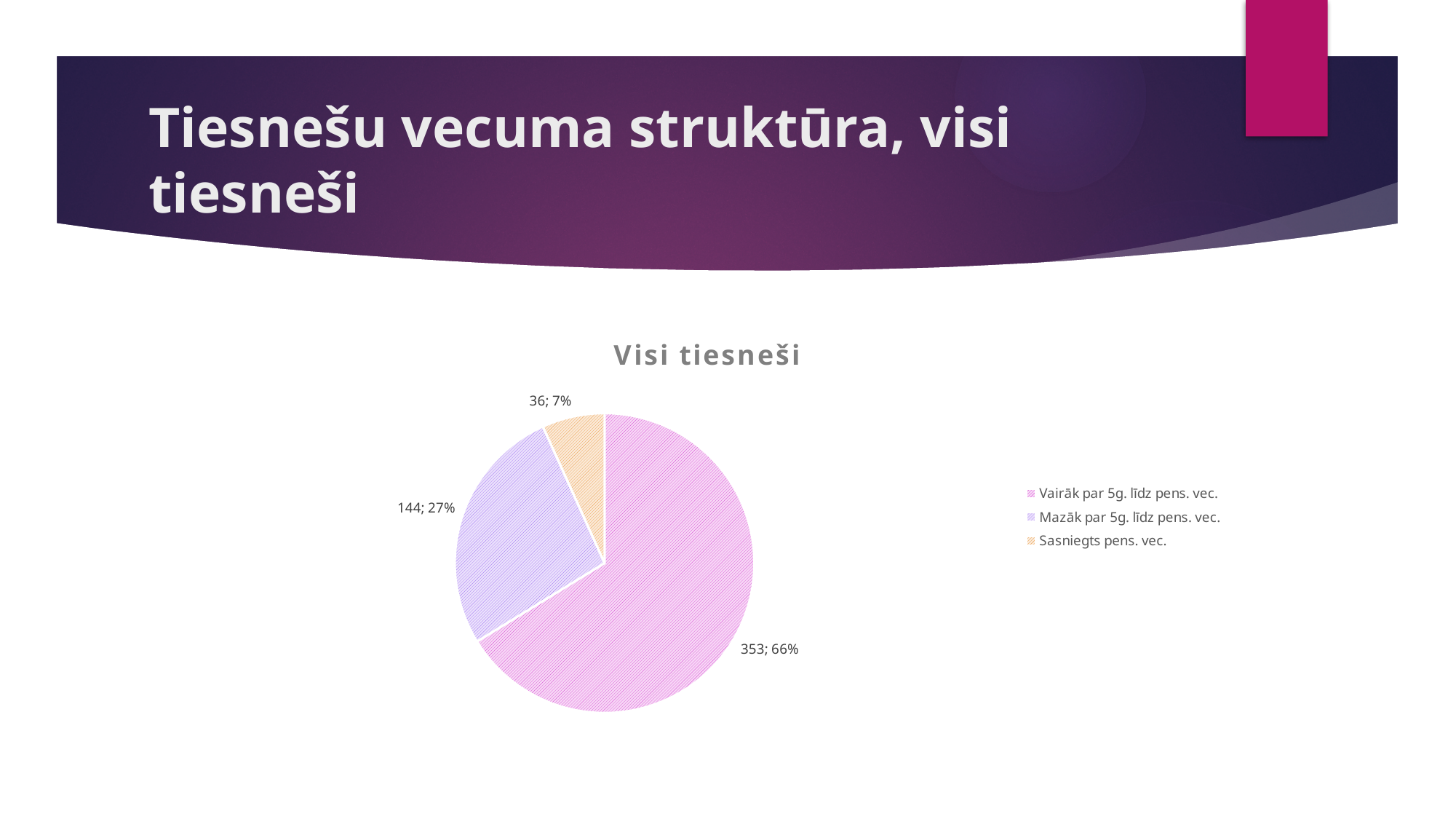
Which category has the largest slice? Vairāk par 5g. līdz pens. vec. What is the value for "Sasniegts pens. vec."? 36 Which category has the smallest slice? Sasniegts pens. vec. What share of the pie does "Mazāk par 5g. līdz pens. vec." represent? 27% How many slices does the pie chart have? 3 What is the title of the chart? Visi tiesneši What kind of chart is shown on the slide? pie chart How many entries does the legend list? 3 What share of the pie does "Sasniegts pens. vec." represent? 7% What is the difference between the values for "Vairāk par 5g. līdz pens. vec." and "Mazāk par 5g. līdz pens. vec."? 209 What is the value for "Vairāk par 5g. līdz pens. vec."? 353 What is the value for "Mazāk par 5g. līdz pens. vec."? 144